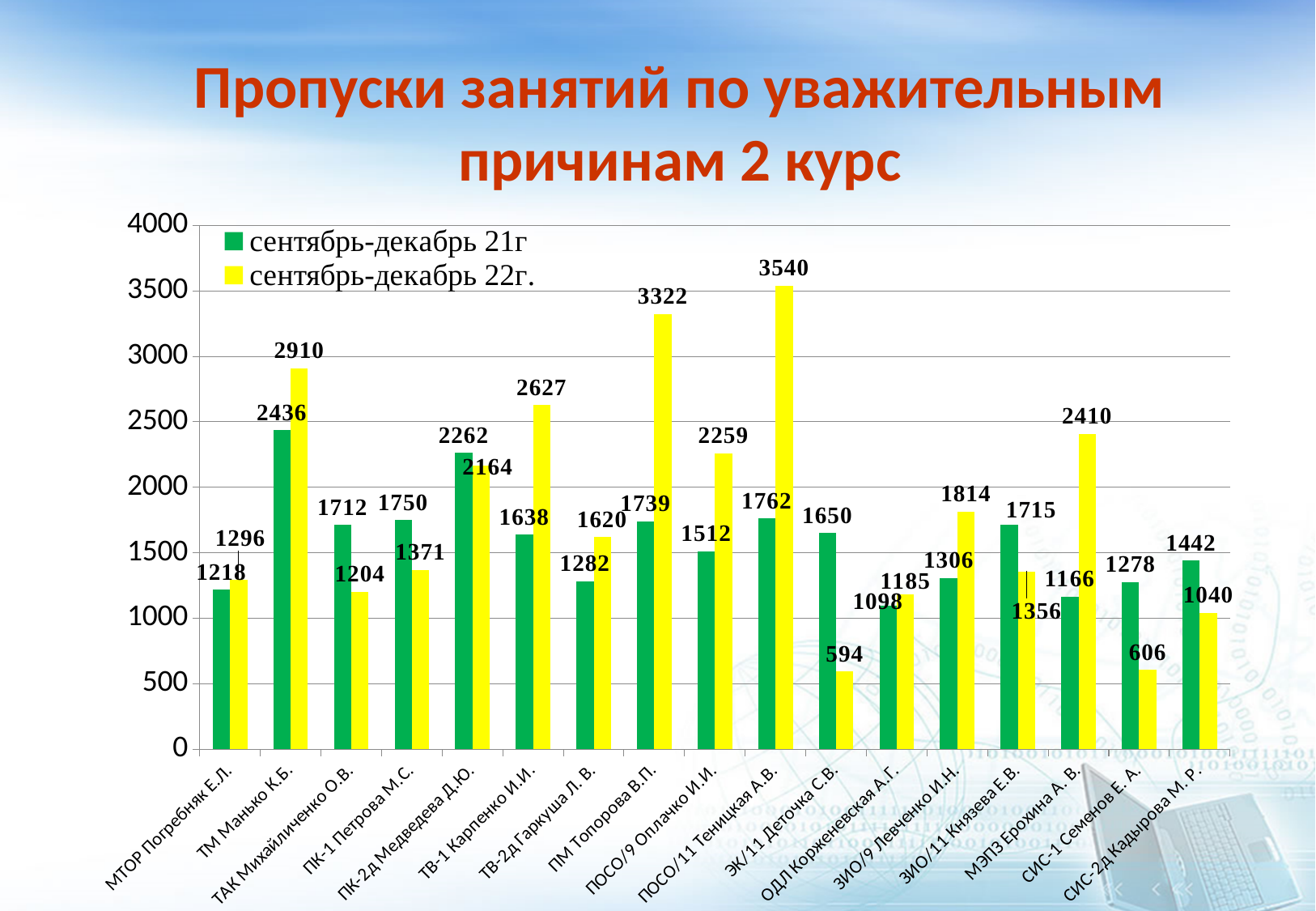
What is the value for ЭК/11 Деточка С.В. in the сентябрь-декабрь 22г. series? 594 Which category has the lowest value in the сентябрь-декабрь 21г series? ОДЛ Корженевская А.Г. How many categories (groups) are shown on the x axis? 17 For СИС-1 Семенов Е.А., which series has the larger value: сентябрь-декабрь 21г or сентябрь-декабрь 22г.? сентябрь-декабрь 21г What type of chart is shown on the slide? bar chart What is the value for ПОСО/11 Теницкая А.В. in the сентябрь-декабрь 22г. series? 3540 What colour are the bars for the сентябрь-декабрь 22г. series? yellow Which category has the lowest value in the сентябрь-декабрь 22г. series? ЭК/11 Деточка С.В. What is the difference between the сентябрь-декабрь 22г. and сентябрь-декабрь 21г values for ПМ Топорова В.П.? 1583 Which category has the highest value in the сентябрь-декабрь 22г. series? ПОСО/11 Теницкая А.В. What is the value for ТМ Манько К.Б. in the сентябрь-декабрь 21г series? 2436 How many series does the legend list? 2